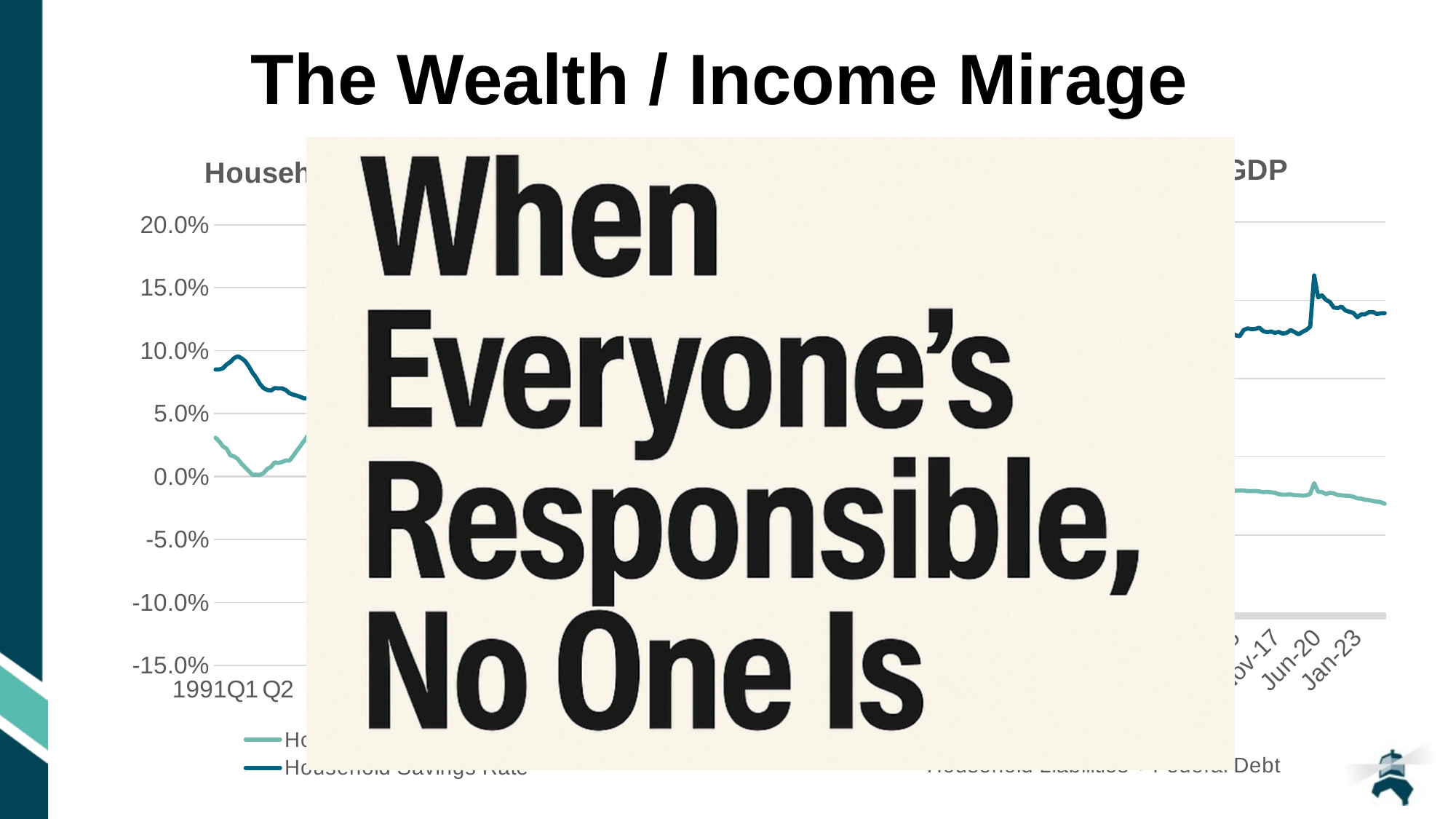
What kind of chart is the chart on the left of the slide? line chart What is the title of the slide? The Wealth / Income Mirage On the left chart, what is the lowest value shown on the vertical axis? -15.0% On the left chart, which series is drawn in the dark teal line according to the legend? Household Savings Rate On the left chart, is the value of the Household Savings Rate line at 1991Q1 greater or less than 5.0%? greater On the left chart, is the value of the Household Savings Rate line at 1991Q1 greater or less than 10.0%? less